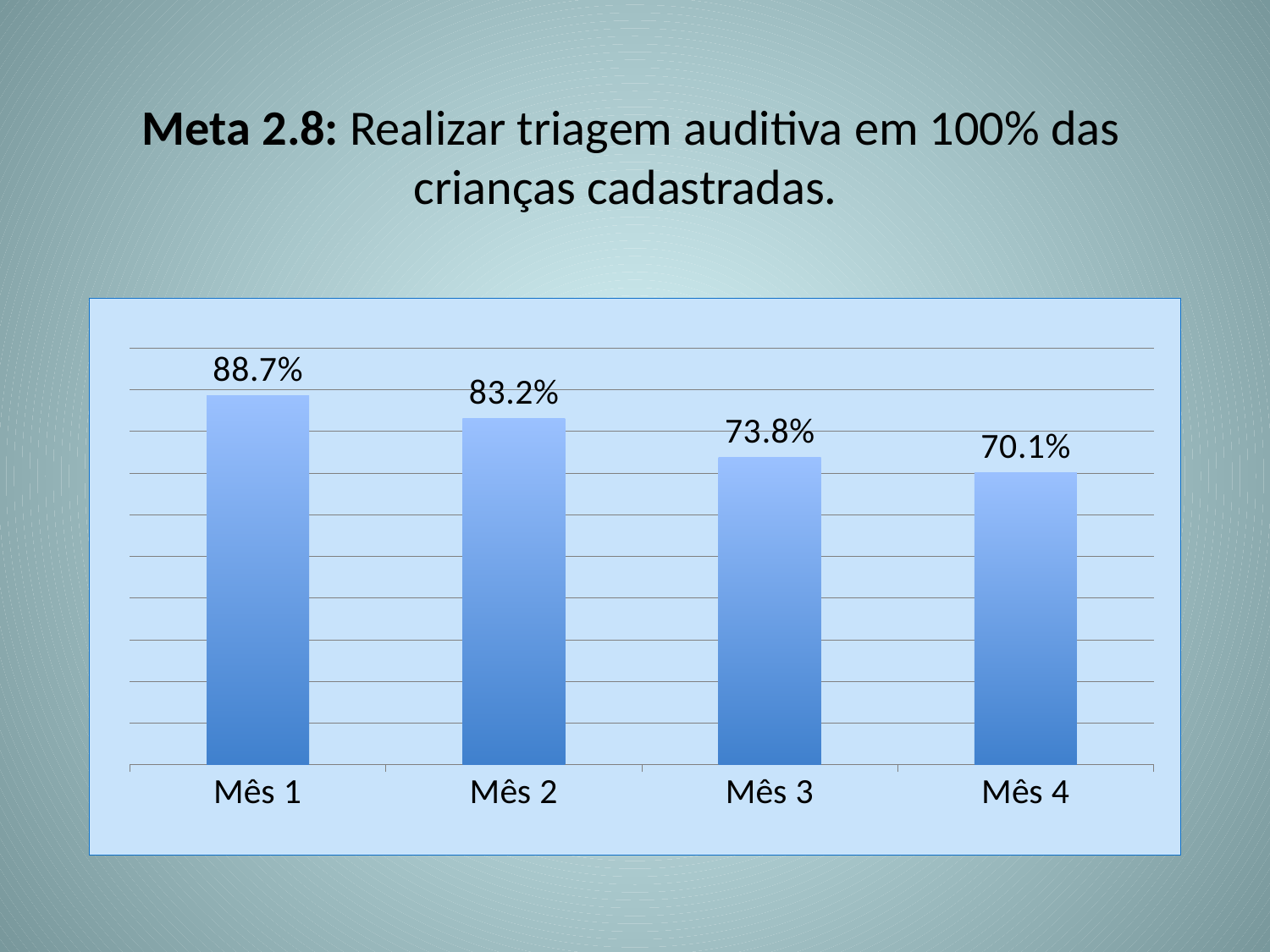
What is the value for Mês 3? 73.8% What is the value for Mês 4? 70.1% What is the difference between the values for Mês 2 and Mês 3? 9.4% How many months are shown on the x axis? 4 What is the value for Mês 2? 83.2% Which month has the highest value? Mês 1 Which month has the lowest value? Mês 4 What kind of chart is shown on the slide? Bar chart Which is larger, the value for Mês 2 or the value for Mês 3? Mês 2 What is the difference between the values for Mês 1 and Mês 4? 18.6% What is the value for Mês 1? 88.7% Do the values rise or fall from Mês 1 to Mês 4? Fall